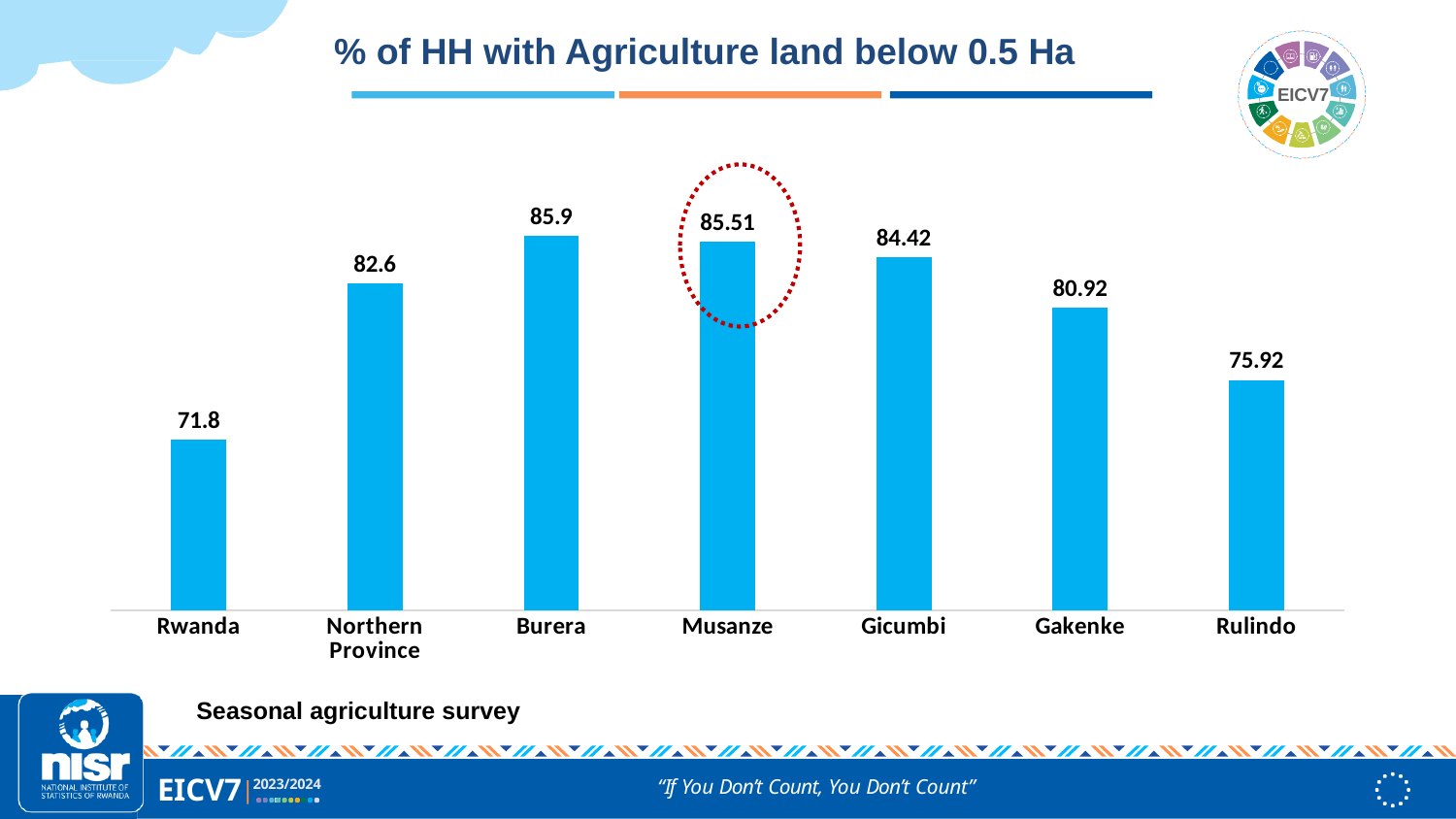
What kind of chart is shown on the slide? Bar chart Which category is highlighted with a dotted red circle? Musanze What is the value for Gakenke? 80.92 What is the value for Northern Province? 82.6 What is the value for Rwanda? 71.8 How many categories are shown on the x axis? 7 What is the difference between the values for Burera and Rulindo? 9.98 Which category has the highest value? Burera What is the difference between the values for Gicumbi and Gakenke? 3.5 Which category has the lowest value? Rwanda Which is larger, the value for Gicumbi or the value for Rulindo? Gicumbi What is the value for Musanze? 85.51